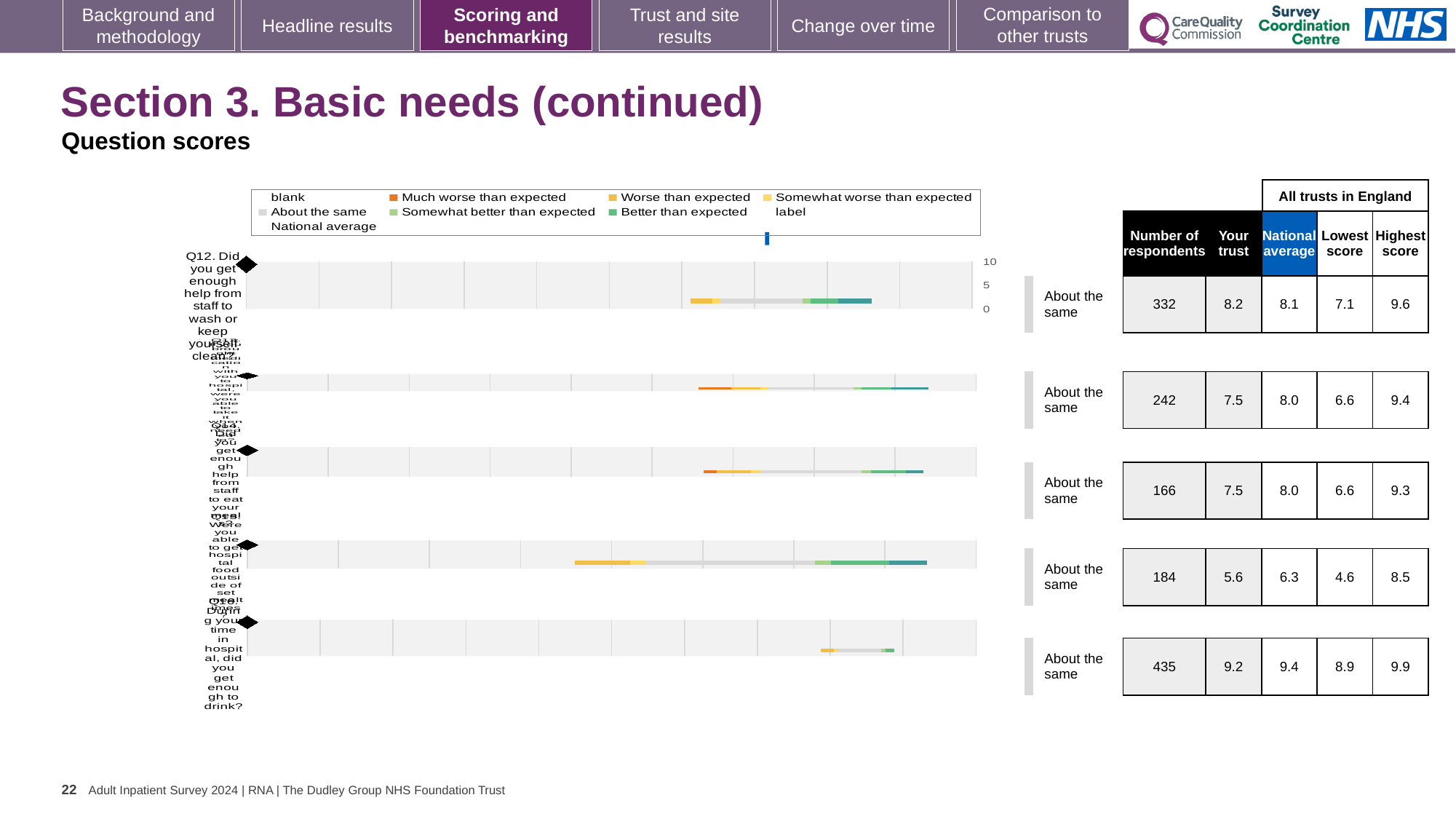
What is the national average for the last row (Q16, did you get enough to drink)? 9.4 What is the 'Your trust' score for the first row (Q12, help from staff to wash or keep yourself clean)? 8.2 For the fourth row (Q15), what is the difference between the highest score and the lowest score across all trusts in England? 3.9 Which question row has the lowest 'Your trust' score? Q15 For the first row (Q12), what is the difference between the 'Your trust' score and the national average? 0.1 What kind of chart is shown on the slide? bar chart What colour does the legend use for 'Much worse than expected'? orange How many questions (rows) are plotted in the chart? 5 How many respondents are listed for the fourth row (Q15, hospital food outside of set meal times)? 184 For the second row (Q13), which is larger: the 'Your trust' score or the national average? National average What benchmark category is shown next to every row of the chart? About the same Which question row has the highest 'Your trust' score? Q16